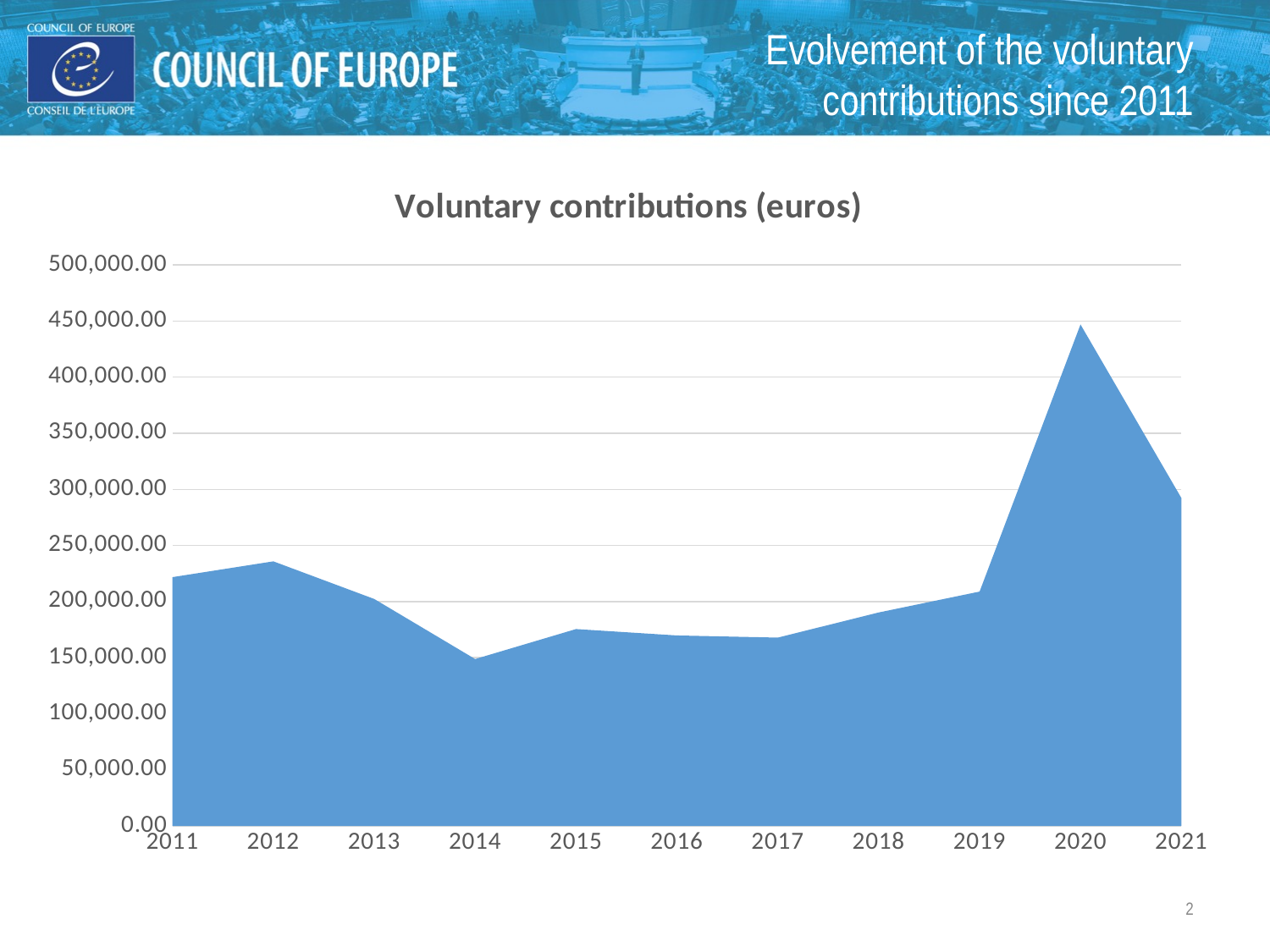
Which year has the larger voluntary contributions, 2020 or 2021? 2020 Is the value for 2020 greater or less than 400,000.00? greater Which year has the highest voluntary contributions? 2020 Is the value for 2014 greater or less than 200,000.00? less Which year has the lowest voluntary contributions? 2014 How many years are plotted along the x axis of the chart? 11 Is the value for 2021 greater or less than 250,000.00? greater What kind of chart is shown on the slide? Area chart Do the voluntary contributions rise or fall from 2017 to 2020? rise What is the title of the chart? Voluntary contributions (euros) Which year has the larger voluntary contributions, 2012 or 2014? 2012